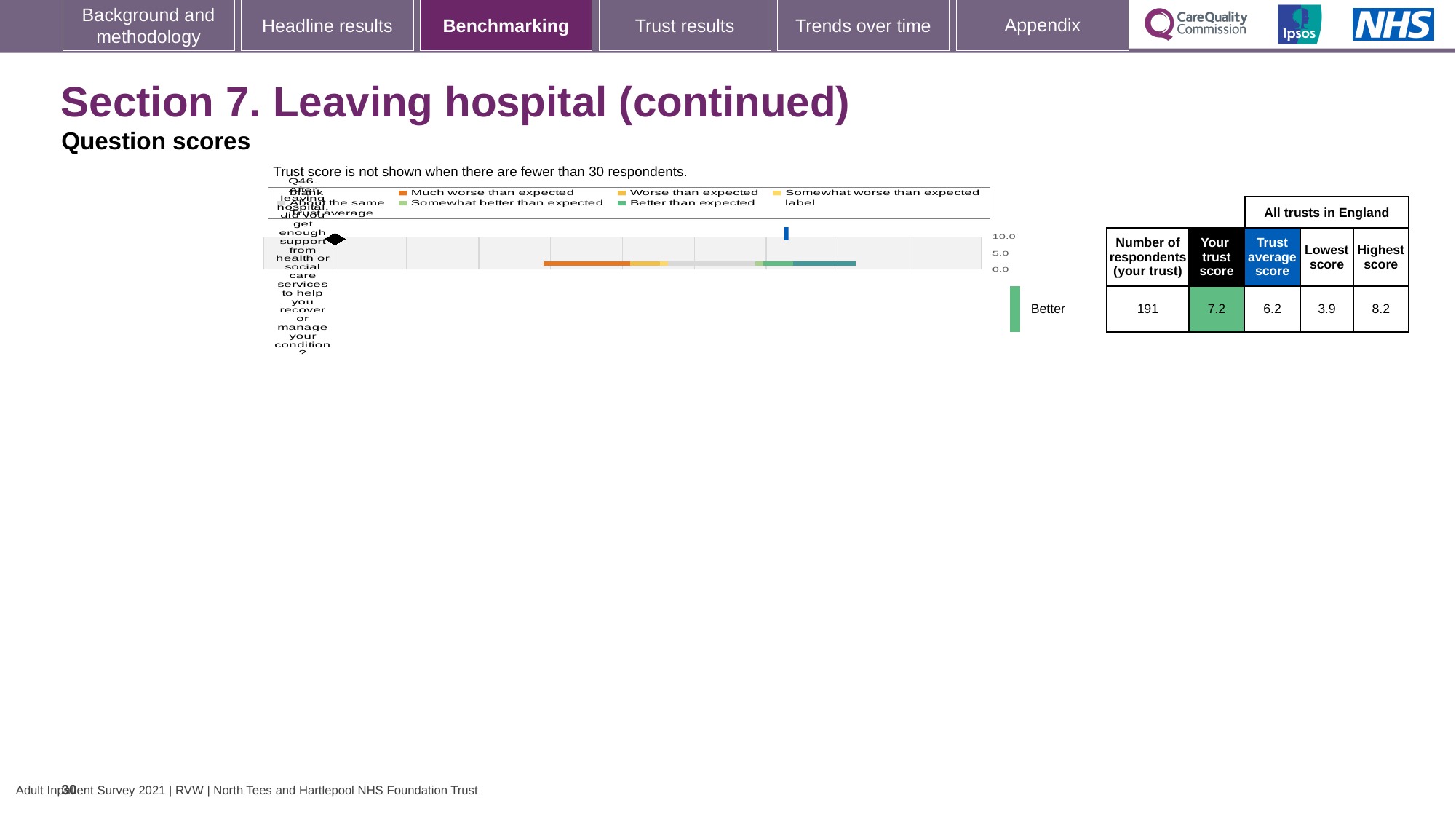
What is the 'Highest score' across all trusts in England for Q46? 8.2 What is the difference between the 'Your trust score' and the 'Trust average score' for Q46? 1.0 What is the 'Lowest score' across all trusts in England for Q46? 3.9 What kind of chart is shown on the slide? bar chart Which is larger for Q46, the 'Your trust score' or the 'Trust average score'? Your trust score How many survey questions are plotted in the chart? 1 What is the highest value shown on the chart's axis? 10.0 How many respondents from the trust answered Q46? 191 What rating label is shown next to the chart for Q46? Better What is the 'Trust average score' for Q46? 6.2 What is the difference between the 'Highest score' and the 'Lowest score' for Q46? 4.3 What is the 'Your trust score' value for Q46? 7.2